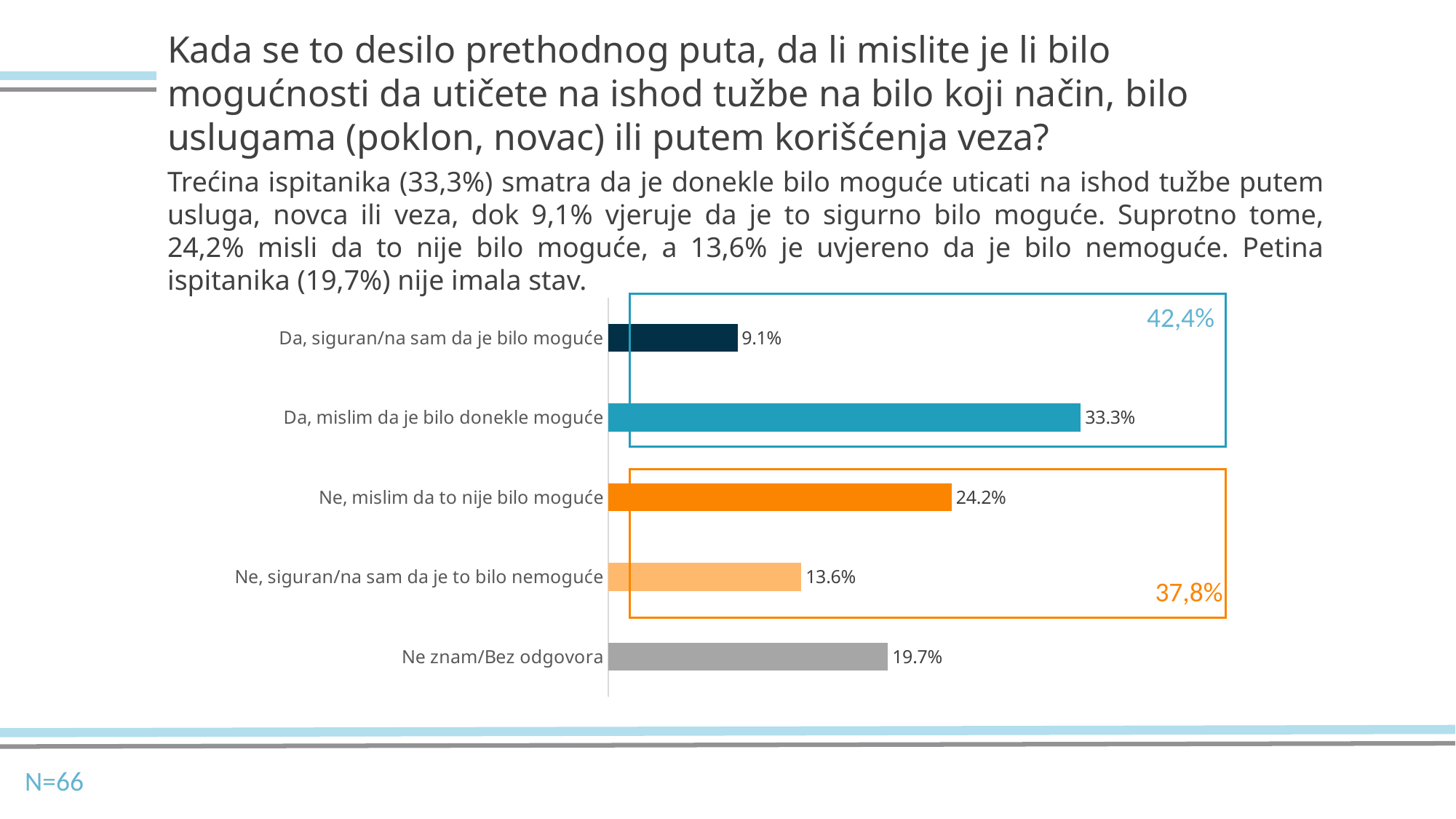
Which category has the highest value? Da, mislim da je bilo donekle moguće What combined percentage is shown in the orange box grouping the two "Ne" answers? 37,8% Which is larger, the value for "Ne znam/Bez odgovora" or the value for "Ne, siguran/na sam da je to bilo nemoguće"? Ne znam/Bez odgovora What is the value for "Da, siguran/na sam da je bilo moguće"? 9.1% What is the value for "Da, mislim da je bilo donekle moguće"? 33.3% What is the difference between the values for "Ne, mislim da to nije bilo moguće" and "Ne, siguran/na sam da je to bilo nemoguće"? 10.6% What combined percentage is shown in the blue box grouping the two "Da" answers? 42,4% Which category has the lowest value? Da, siguran/na sam da je bilo moguće How many categories are shown in the chart? 5 What is the value for "Ne znam/Bez odgovora"? 19.7% What is the value for "Ne, siguran/na sam da je to bilo nemoguće"? 13.6% What kind of chart is shown on the slide? Bar chart